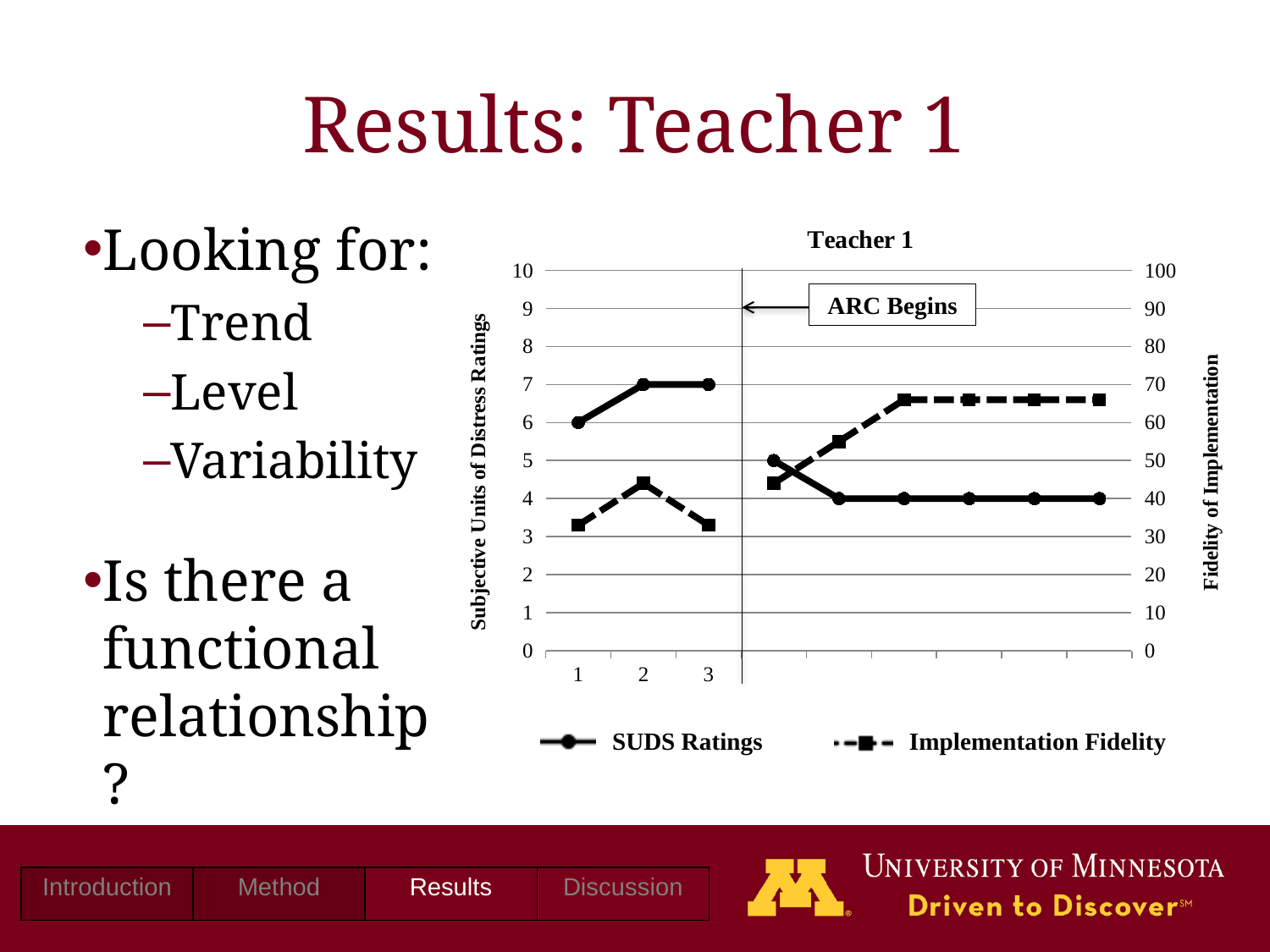
Which session has the lower SUDS Rating, session 1 or session 2? session 1 What kind of chart is shown on the slide? line chart What is the SUDS Rating at session 1 on the Teacher 1 chart? 6 What are the two series named in the legend of the Teacher 1 chart? SUDS Ratings and Implementation Fidelity What is the SUDS Rating at session 2 on the Teacher 1 chart? 7 After ARC begins, do the SUDS Ratings rise or fall over the sessions? fall Is the Implementation Fidelity value at session 1 greater or less than 40? less What event does the vertical line with the label box mark on the Teacher 1 chart? ARC Begins Is the Implementation Fidelity value at session 2 greater or less than 40? greater What is the SUDS Rating at session 3 on the Teacher 1 chart? 7 How many series does the legend of the Teacher 1 chart list? 2 By how much does the SUDS Rating increase from session 1 to session 2? 1